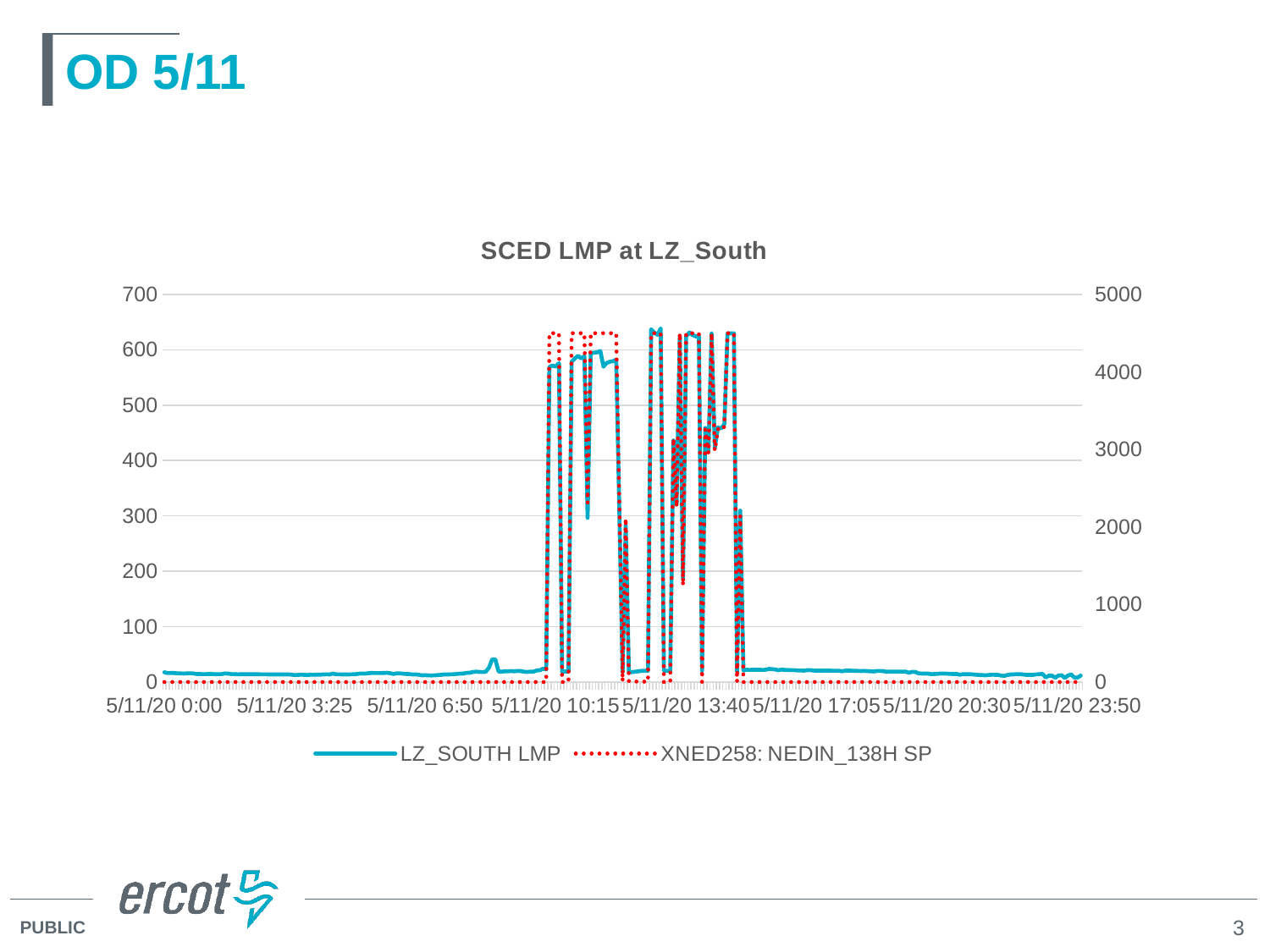
What is the last time label on the x axis? 5/11/20 23:50 What is the highest value shown on the right vertical axis? 5000 On the left axis, is the peak LZ_SOUTH LMP value greater or less than 500? greater What is the first time label on the x axis? 5/11/20 0:00 What kind of chart is shown on the slide? line chart How many series does the chart's legend list? 2 How many time labels are shown along the x axis? 8 On the left axis, is the LZ_SOUTH LMP value at 5/11/20 0:00 greater or less than 100? less Is the LZ_SOUTH LMP higher at 5/11/20 0:00 or at 5/11/20 10:15? 5/11/20 10:15 Which series is drawn as a red dotted line? XNED258: NEDIN_138H SP What is the highest value shown on the left vertical axis? 700 What is the title of the chart? SCED LMP at LZ_South